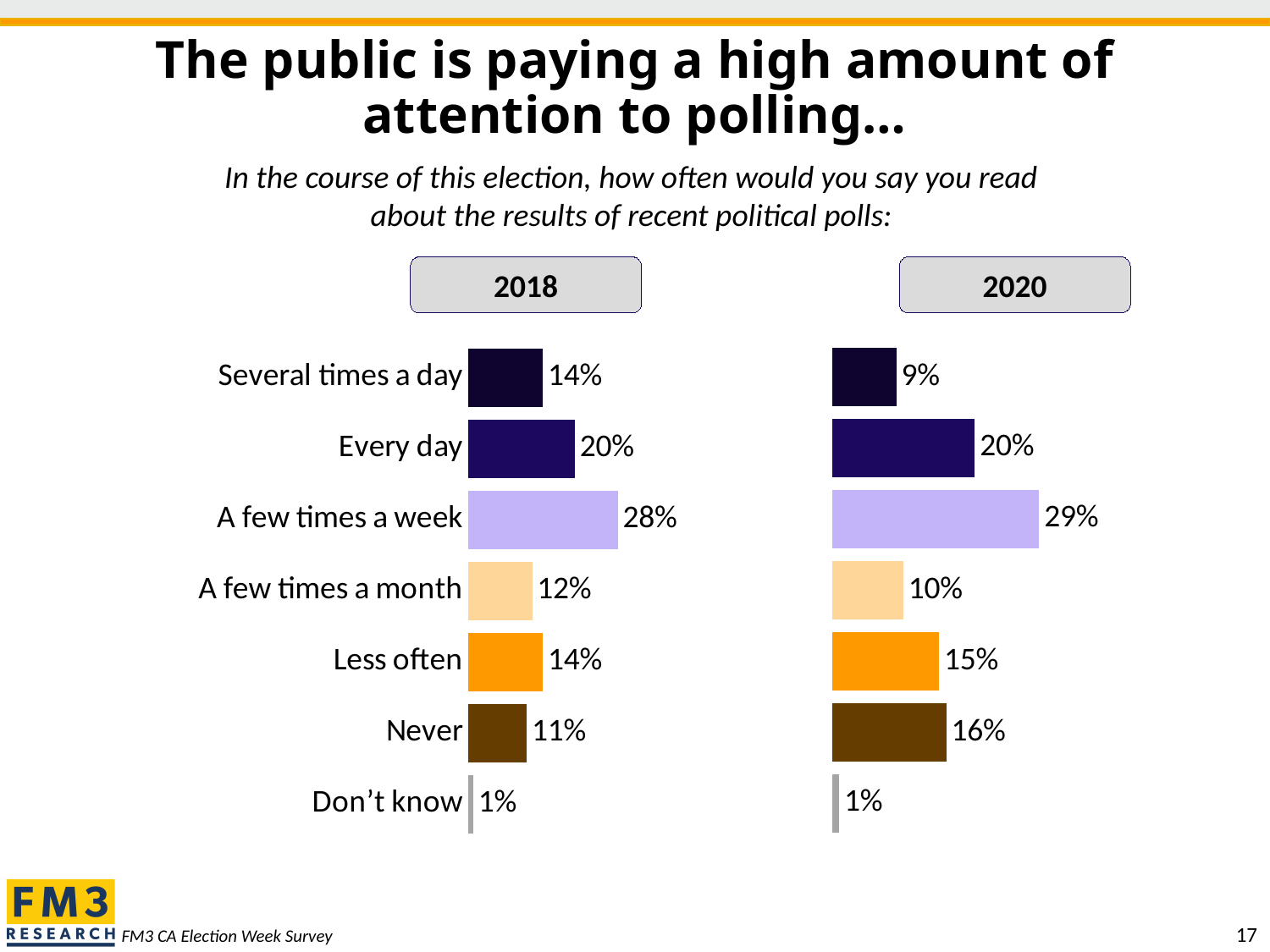
In the 2018 chart, which category has the highest value? A few times a week What is the total of the 2020 values for 'Several times a day' and 'Every day'? 29% What is the difference between the 2018 values for 'A few times a week' and 'Every day'? 8% In the 2020 chart, which category has the lowest value? Don't know In the 2020 chart, what percentage said they read about poll results a few times a week? 29% What type of chart is used on this slide? Bar chart Which is larger: the 2018 value for 'Several times a day' or the 2020 value for 'Several times a day'? 2018 In the 2018 chart, what percentage said they read about poll results several times a day? 14% What is the difference between the 2020 and 2018 values for 'Never'? 5% How many categories are shown in the 2018 chart? 7 In the 2020 chart, what percentage said they never read about poll results? 16% In the 2020 chart, which is larger: 'Less often' or 'A few times a month'? Less often